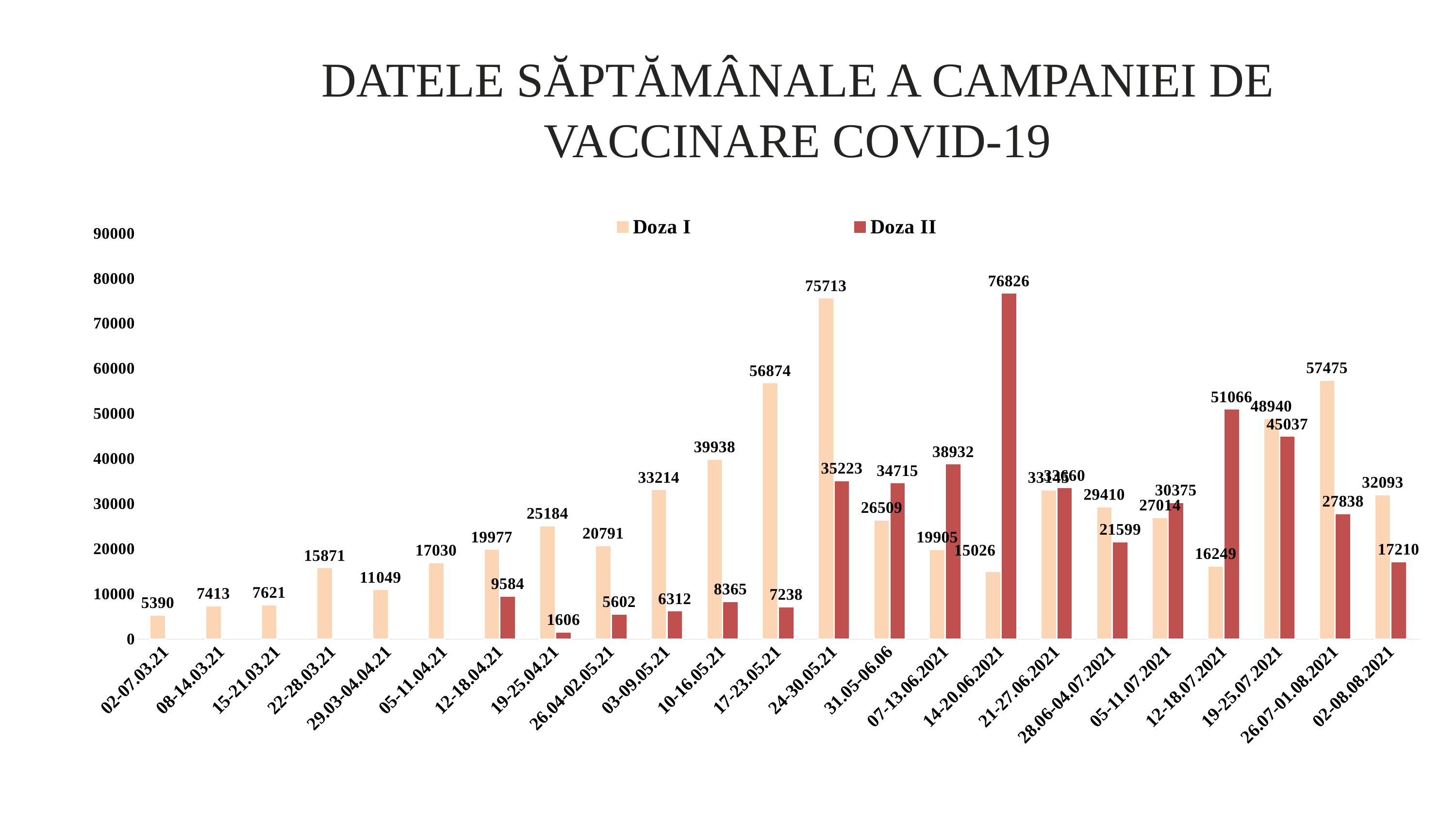
What is the Doza I value for the week 24-30.05.21? 75713 How many weekly categories are shown on the x axis? 23 Is the Doza I value for the week 17-23.05.21 greater or less than 50000? greater What is the Doza II value for the week 12-18.07.2021? 51066 For the week 26.07-01.08.2021, which is larger, Doza I or Doza II? Doza I What is the Doza I value for the week 02-07.03.21? 5390 What is the difference between Doza I and Doza II for the week 24-30.05.21? 40490 What is the Doza II value for the week 14-20.06.2021? 76826 What kind of chart is shown on the slide? bar chart Which week has the lowest Doza II value? 19-25.04.21 How many series does the legend list? 2 Which week has the highest Doza I value? 24-30.05.21